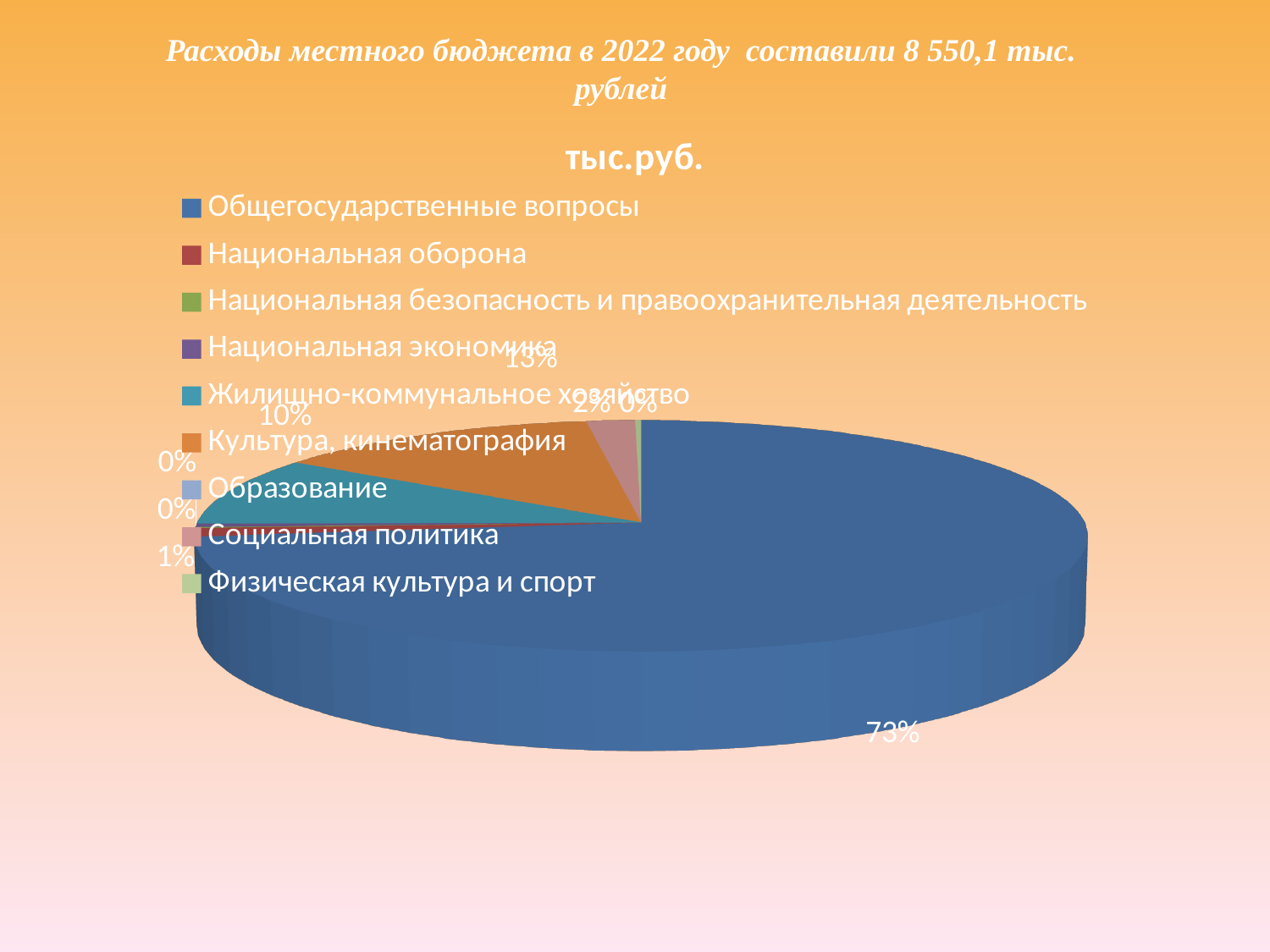
What kind of chart is shown on the slide? pie chart What share of the pie does Культура, кинематография have? 13% What is the difference in percentage points between the shares of Культура, кинематография and Жилищно-коммунальное хозяйство? 3% Which has the larger share: Культура, кинематография or Жилищно-коммунальное хозяйство? Культура, кинематография Which category has the largest share of the pie chart? Общегосударственные вопросы What colour is the slice for Общегосударственные вопросы? blue What share of the pie does Общегосударственные вопросы have? 73% How many categories does the legend of the pie chart list? 9 What is the difference in percentage points between the shares of Общегосударственные вопросы and Культура, кинематография? 60% What share of the pie does Жилищно-коммунальное хозяйство have? 10% What is the title of the pie chart? тыс.руб.